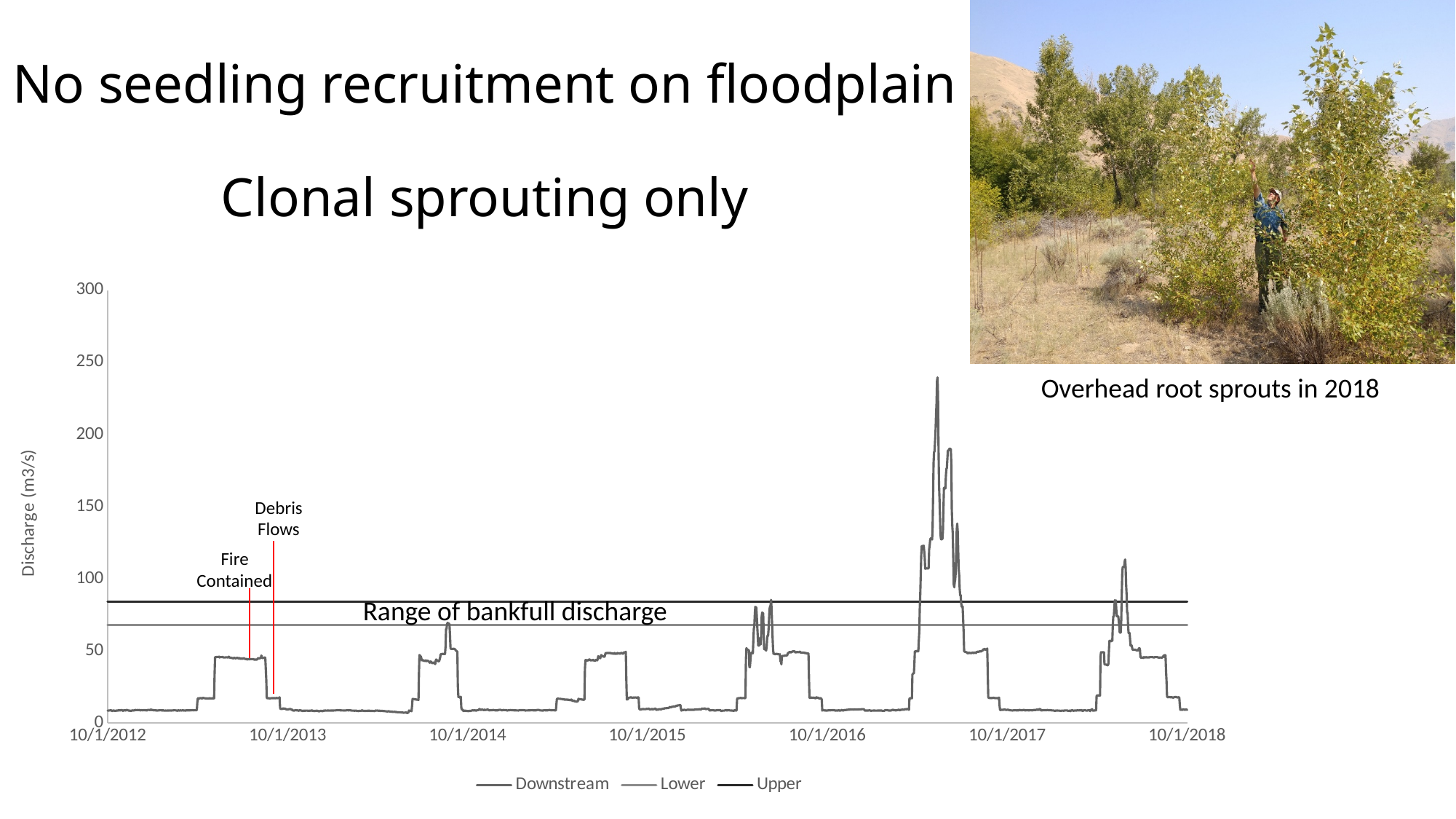
What are the three series named in the chart legend? Downstream, Lower, Upper What kind of chart is shown on the slide? line chart Is the highest peak of the Downstream series, in 2017, greater or less than 200? greater How many series does the chart legend list? 3 Is the Lower line on the chart greater or less than 50? greater Is the Upper line on the chart greater or less than 100? less What is the first date shown on the horizontal axis of the chart? 10/1/2012 What is the label on the vertical axis of the chart? Discharge (m3/s) What is the last date shown on the horizontal axis of the chart? 10/1/2018 What is the maximum value shown on the vertical axis of the chart? 300 Which is higher on the chart, the Upper line or the Lower line? Upper